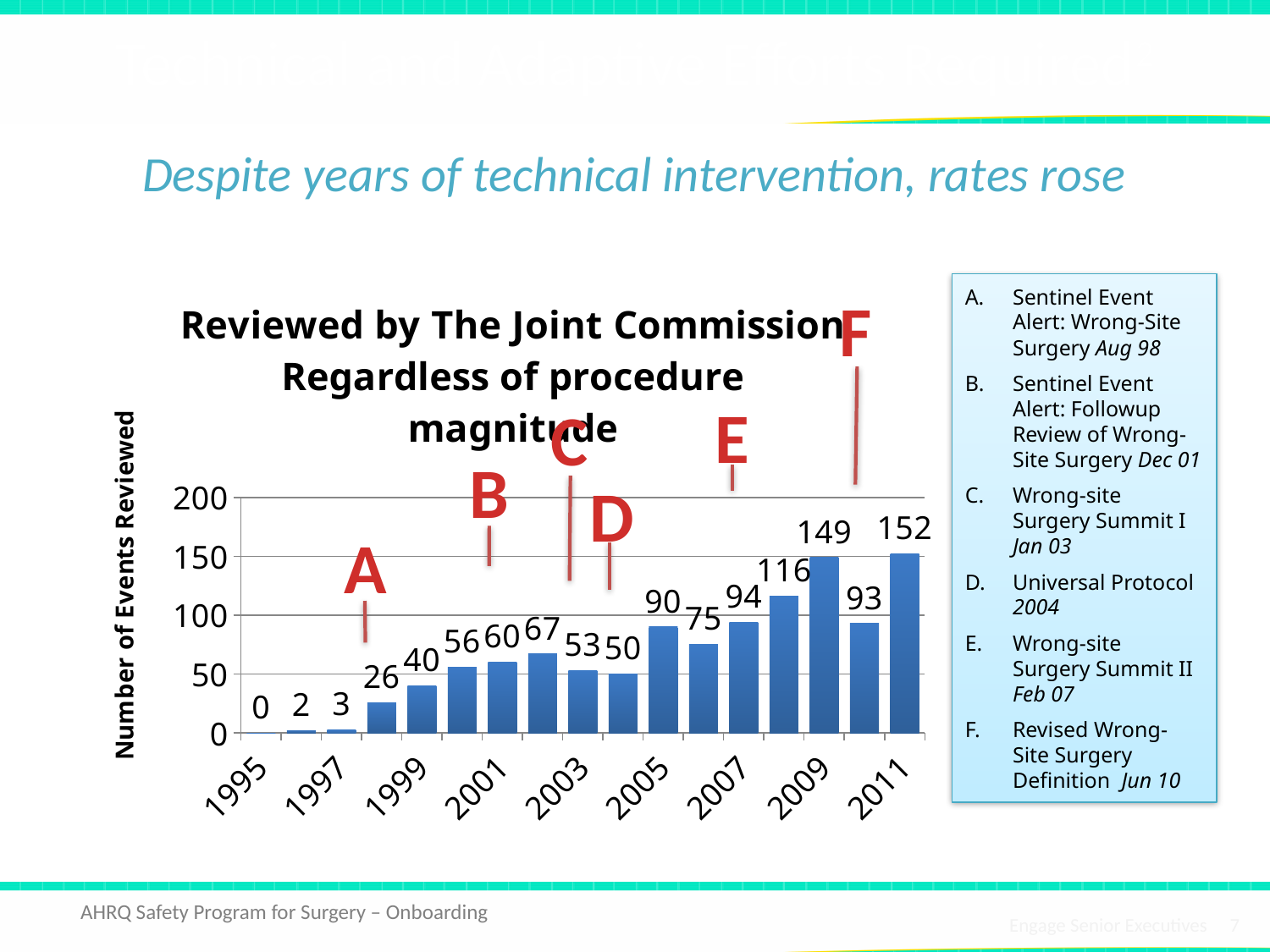
What is the label on the vertical axis of the chart? Number of Events Reviewed What kind of chart is shown on the slide? bar chart What is the difference between the values for 2011 and 2009? 3 What is the number of events reviewed in 2011? 152 Overall, do the values rise or fall from 1995 to 2011? rise What is the number of events reviewed in 2009? 149 What is the number of events reviewed in 2005? 90 Which is larger, the value for 2007 or the value for 2005? 2007 Which year has the lowest number of events reviewed? 1995 How many bars (years) are plotted in the chart? 17 What is the number of events reviewed in 1999? 40 Which year has the highest number of events reviewed? 2011